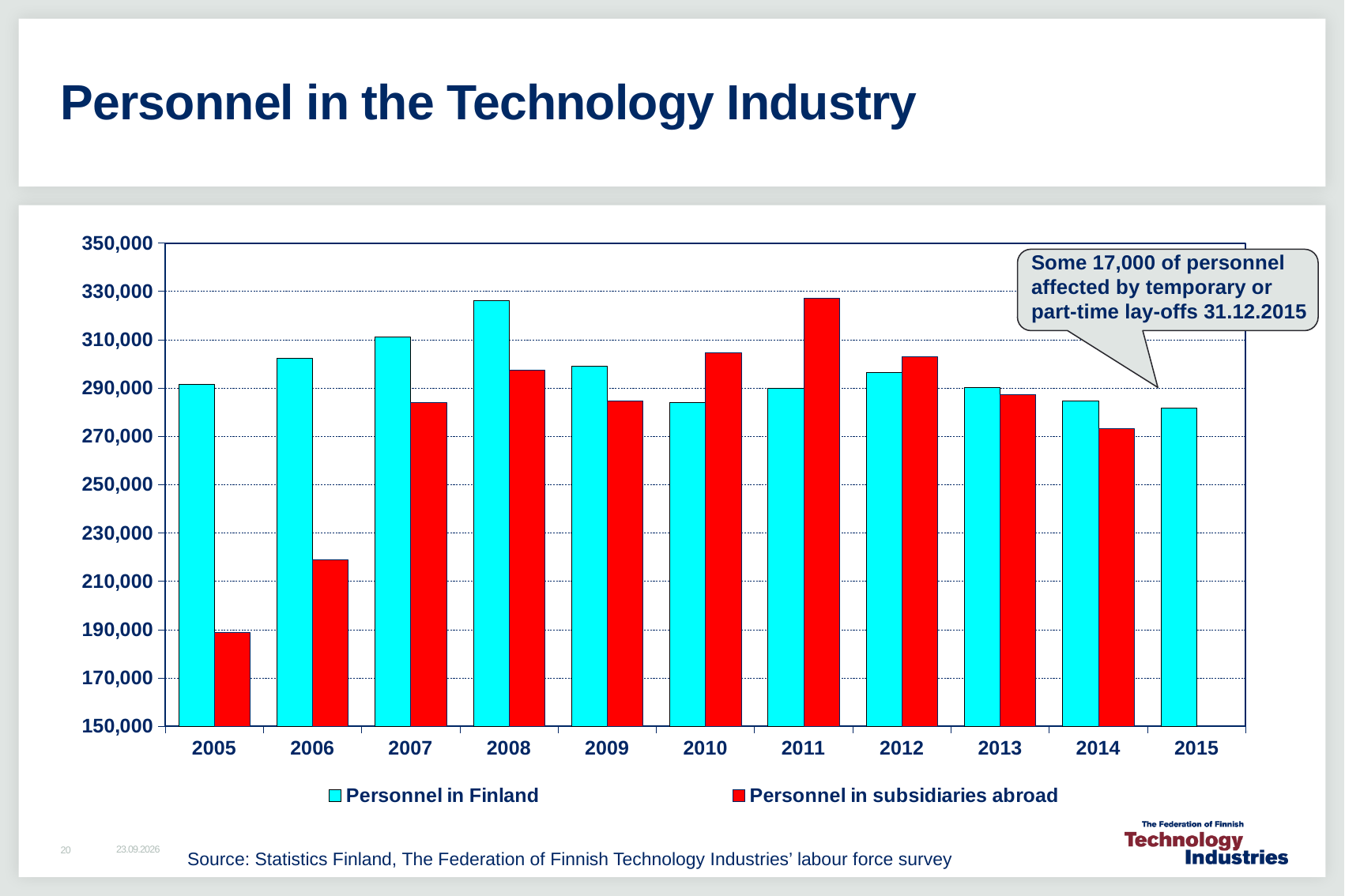
Does Personnel in subsidiaries abroad rise or fall from 2011 to 2014? Fall Is the value for Personnel in subsidiaries abroad in 2006 greater or less than 210,000? greater How many years are shown on the x axis? 11 In which year is Personnel in Finland highest? 2008 What kind of chart is shown on the slide? Bar chart In which year is Personnel in subsidiaries abroad highest? 2011 Is the value for Personnel in Finland in 2008 greater or less than 310,000? greater In which year is Personnel in subsidiaries abroad lowest? 2005 In 2005, which is larger: Personnel in Finland or Personnel in subsidiaries abroad? Personnel in Finland How many series does the legend list? 2 In 2011, which is larger: Personnel in Finland or Personnel in subsidiaries abroad? Personnel in subsidiaries abroad Is the value for Personnel in subsidiaries abroad in 2014 greater or less than 290,000? less